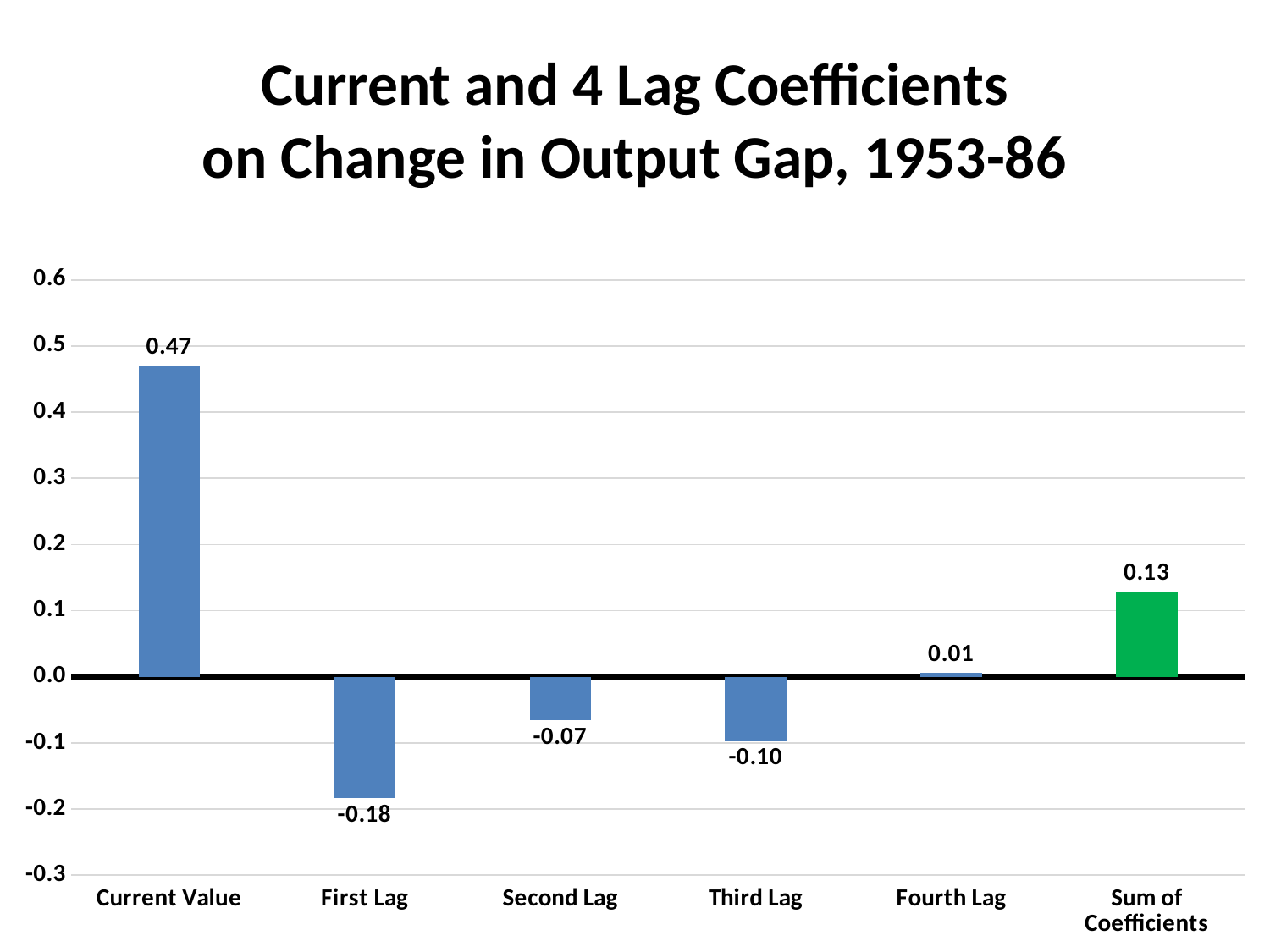
Which category has the highest value? Current Value Which category has the lowest value? First Lag What is the value for Third Lag? -0.10 How many categories are shown on the x axis? 6 Which is larger, the value for Second Lag or the value for Third Lag? Second Lag What is the value for First Lag? -0.18 What kind of chart is this? bar chart What is the difference between the values for Current Value and Sum of Coefficients? 0.34 What is the value for Sum of Coefficients? 0.13 Which bar is coloured green? Sum of Coefficients What is the value for Current Value? 0.47 Is the value for Current Value greater or less than 0.4? greater